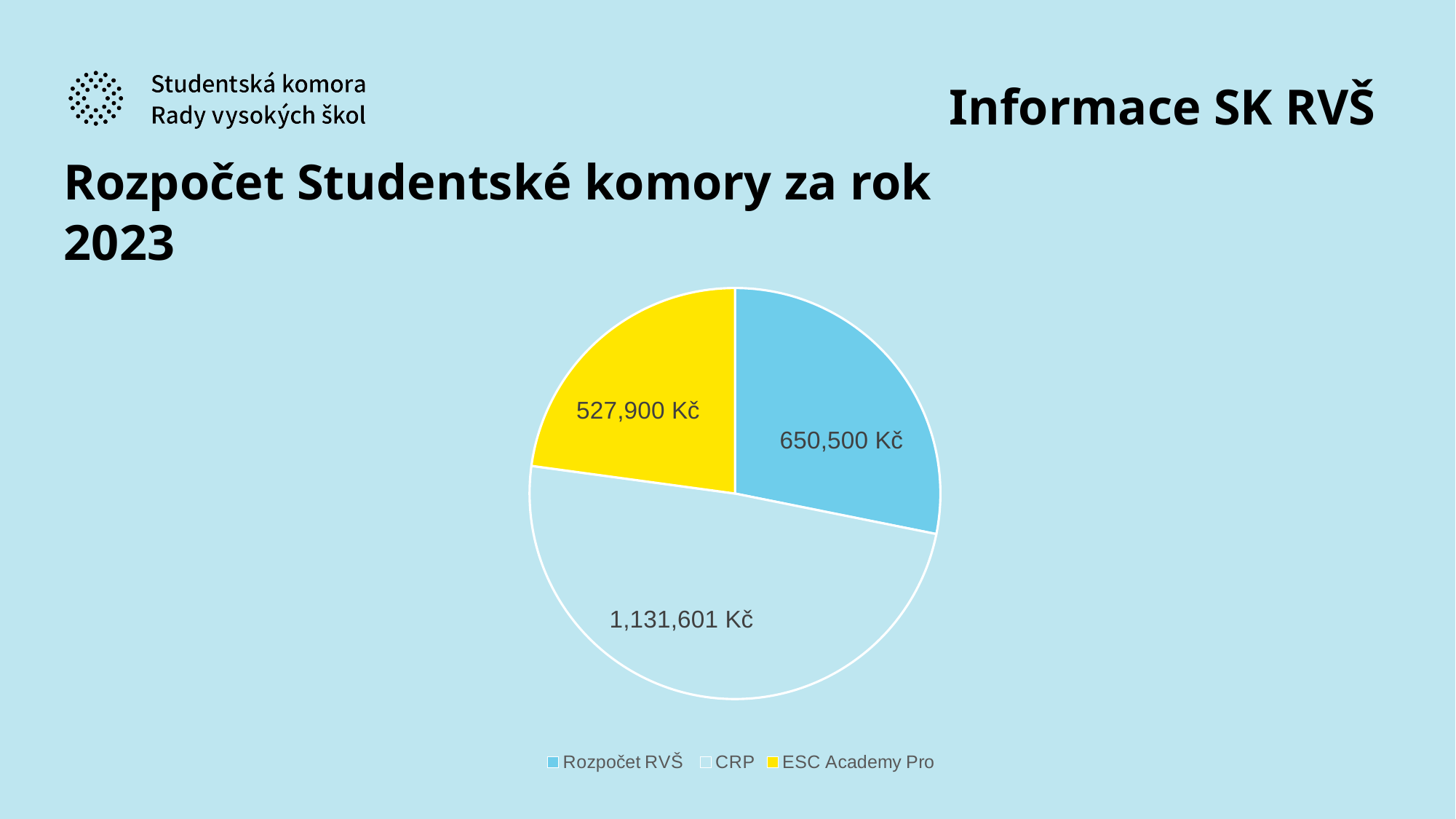
What is the difference between the Rozpočet RVŠ value and the ESC Academy Pro value? 122,600 Kč What is the value of the CRP slice in the pie chart? 1,131,601 Kč What colour is the ESC Academy Pro slice in the pie chart? Yellow What is the difference between the CRP value and the Rozpočet RVŠ value? 481,101 Kč Which category has the smallest slice in the pie chart? ESC Academy Pro What type of chart is shown on the slide? Pie chart What is the value of the Rozpočet RVŠ slice in the pie chart? 650,500 Kč What is the total of all three slices in the pie chart? 2,310,001 Kč Which is larger, the Rozpočet RVŠ slice or the ESC Academy Pro slice? Rozpočet RVŠ Which category has the largest slice in the pie chart? CRP What is the value of the ESC Academy Pro slice in the pie chart? 527,900 Kč How many slices does the pie chart have? 3